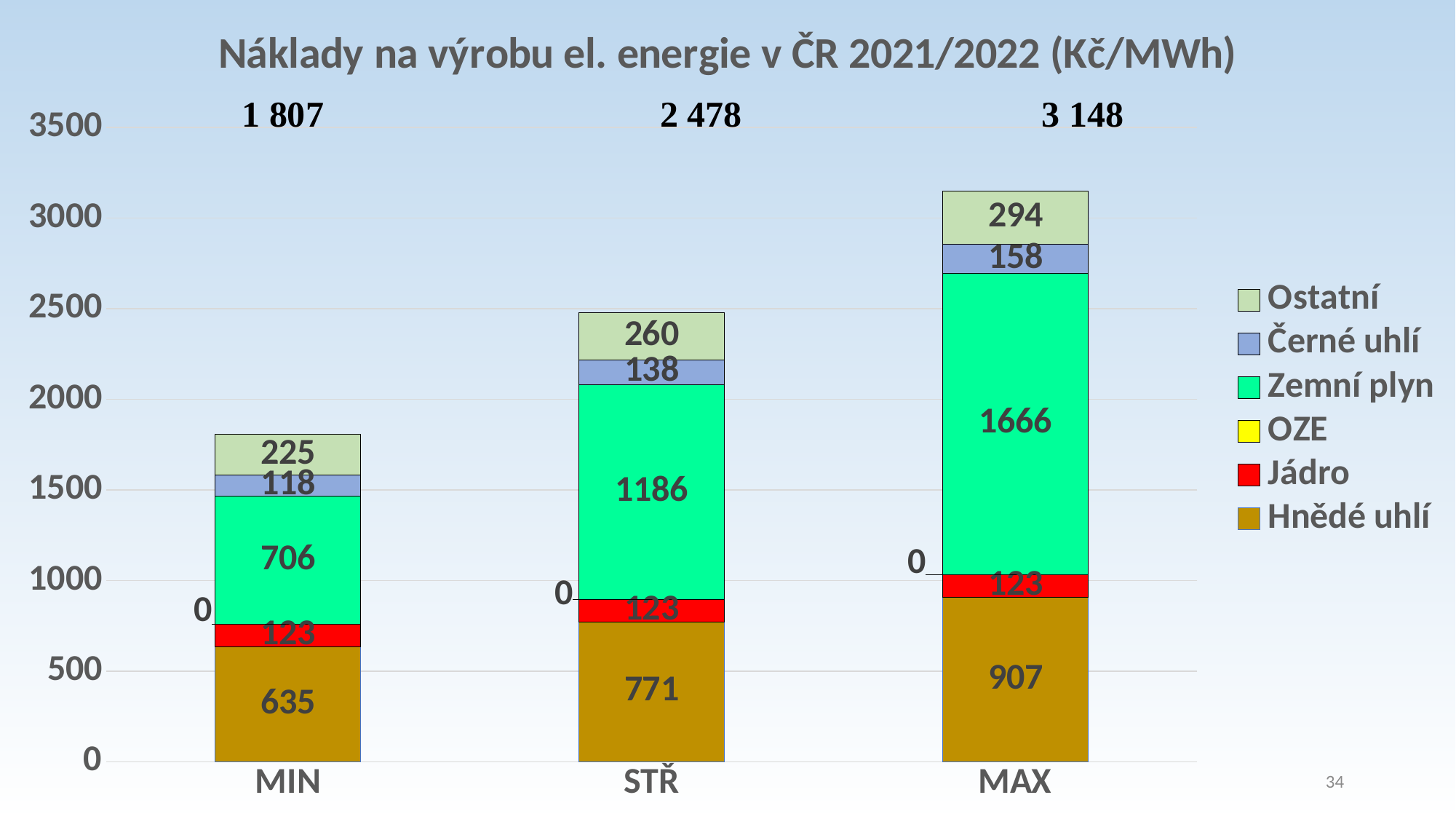
What is the value of Ostatní for the STŘ category? 260 What is the difference between the Hnědé uhlí values for MAX and STŘ? 136 How many series does the legend list? 6 What is the value of Hnědé uhlí for the MIN category? 635 What type of chart is shown on the slide? stacked bar chart What is the total of the stacked bar for STŘ? 2 478 Which is larger: Zemní plyn for STŘ or Hnědé uhlí for MAX? Zemní plyn for STŘ What is the value of Zemní plyn for the MAX category? 1666 What is the title of the chart? Náklady na výrobu el. energie v ČR 2021/2022 (Kč/MWh) What is the value of Černé uhlí for the MAX category? 158 Which category has the highest total cost? MAX Which category has the lowest value for Zemní plyn? MIN